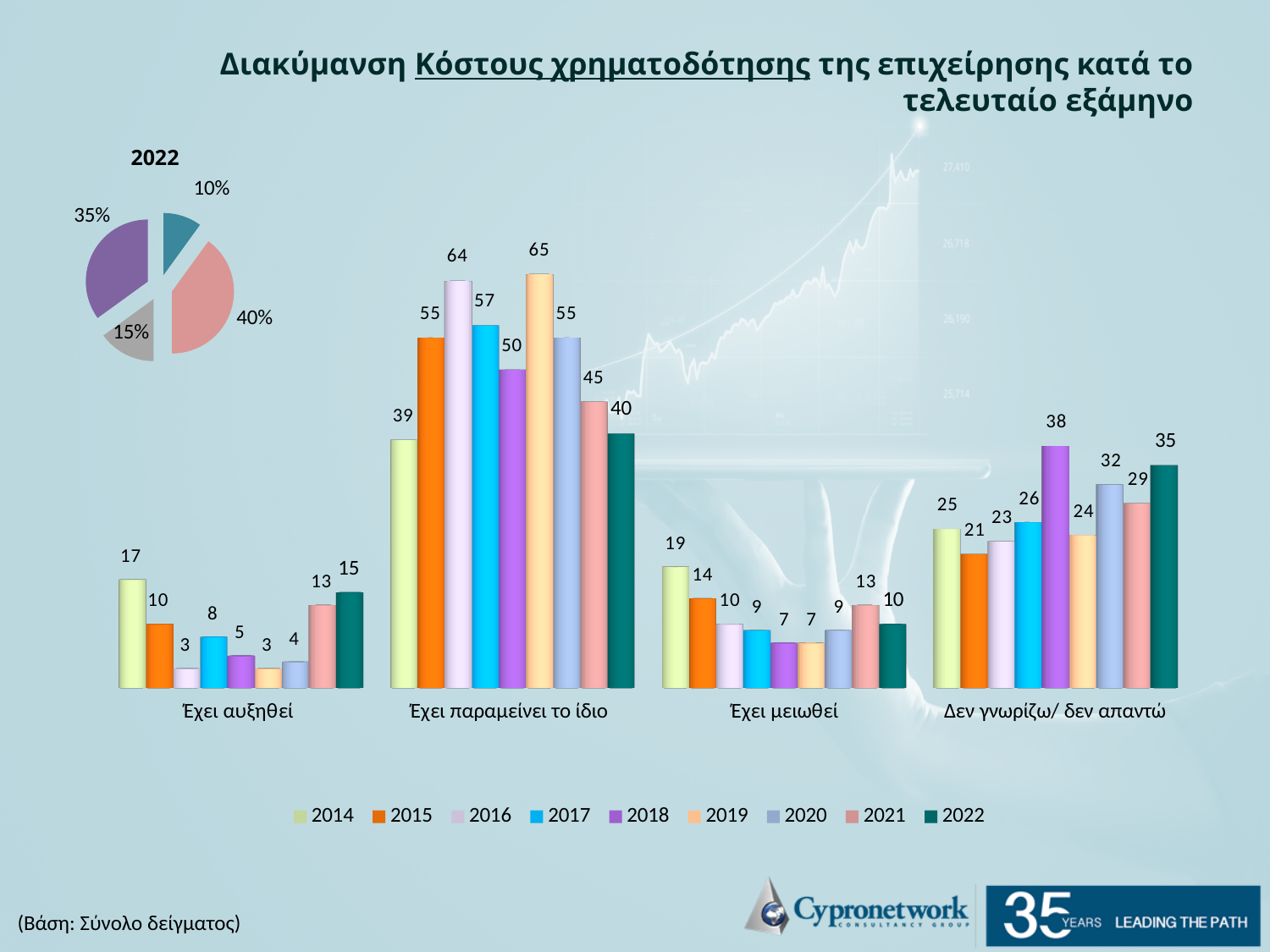
In the bar chart, what is the value for 2022 in the 'Έχει παραμείνει το ίδιο' category? 40 How many series does the legend of the bar chart list? 9 In the bar chart, which is larger in the 'Έχει αυξηθεί' category: the value for 2014 or the value for 2022? 2014 How many categories are shown on the x axis of the bar chart? 4 In the bar chart, which year has the lowest value in the 'Δεν γνωρίζω/ δεν απαντώ' category? 2015 How many slices does the pie chart labelled 2022 have? 4 In the bar chart, what is the value for 2014 in the 'Έχει μειωθεί' category? 19 In the pie chart labelled 2022, what is the share of the largest slice? 40% In the bar chart, which year has the highest value in the 'Έχει παραμείνει το ίδιο' category? 2019 In the bar chart, what is the value for 2018 in the 'Δεν γνωρίζω/ δεν απαντώ' category? 38 What kind of chart is the large chart in the centre of the slide? Bar chart In the bar chart, what is the difference between the 2014 and 2022 values in the 'Έχει παραμείνει το ίδιο' category? 1